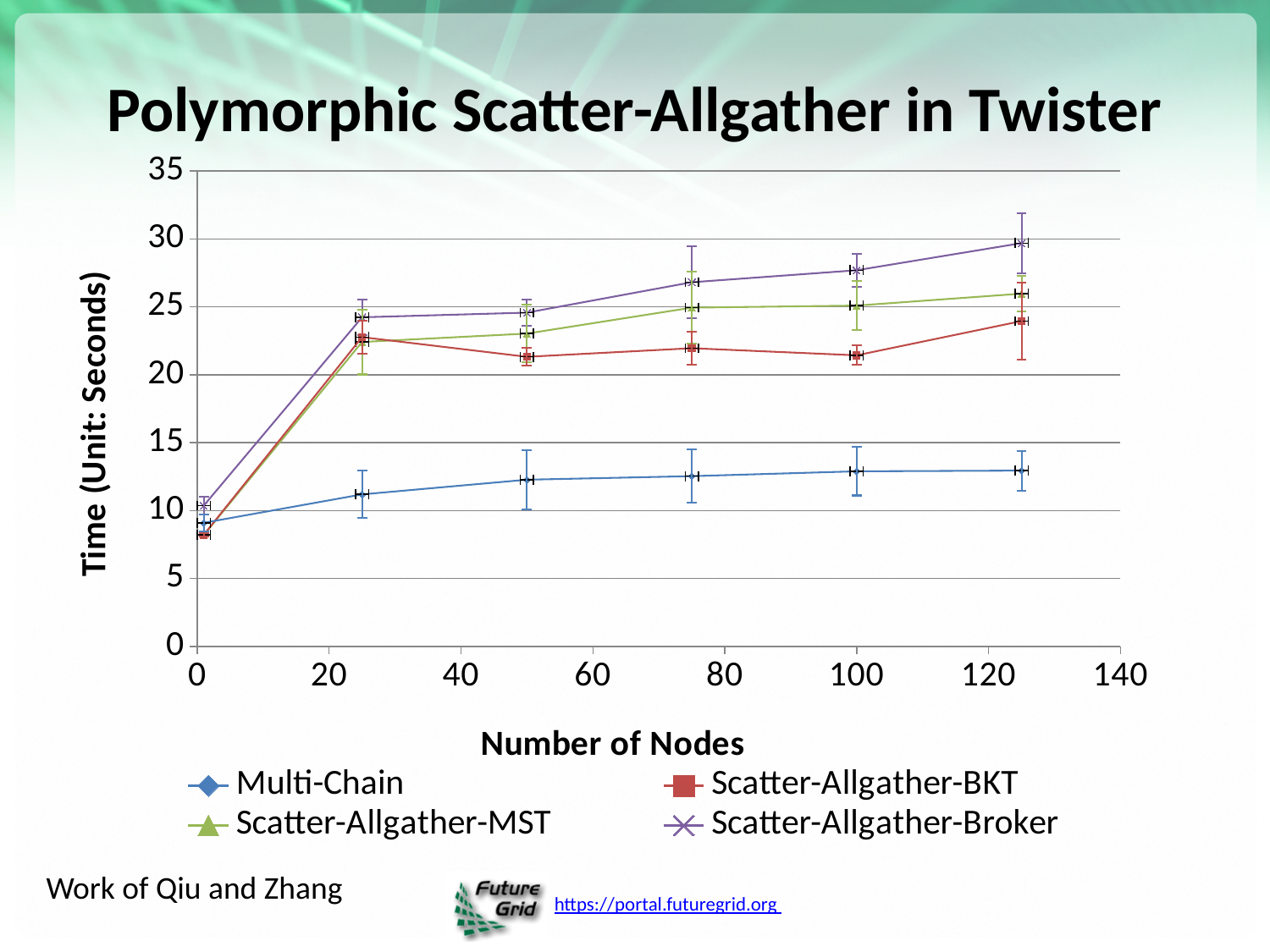
What is the title of the chart? Polymorphic Scatter-Allgather in Twister Is the value for Multi-Chain at 125 nodes greater or less than 15? less Which series has the highest time at 125 nodes? Scatter-Allgather-Broker Is the value for Scatter-Allgather-Broker at 125 nodes greater or less than 25? greater How many series does the legend list? 4 Is the value for Scatter-Allgather-BKT at 100 nodes greater or less than 20? greater At 75 nodes, which is larger: Scatter-Allgather-MST or Scatter-Allgather-BKT? Scatter-Allgather-MST Which series has the lowest time at 100 nodes? Multi-Chain How many data points are plotted for the Multi-Chain series? 6 Does the Scatter-Allgather-Broker series generally rise or fall as the number of nodes increases? rise What kind of chart is shown on the slide? line chart What is the label of the y axis? Time (Unit: Seconds)